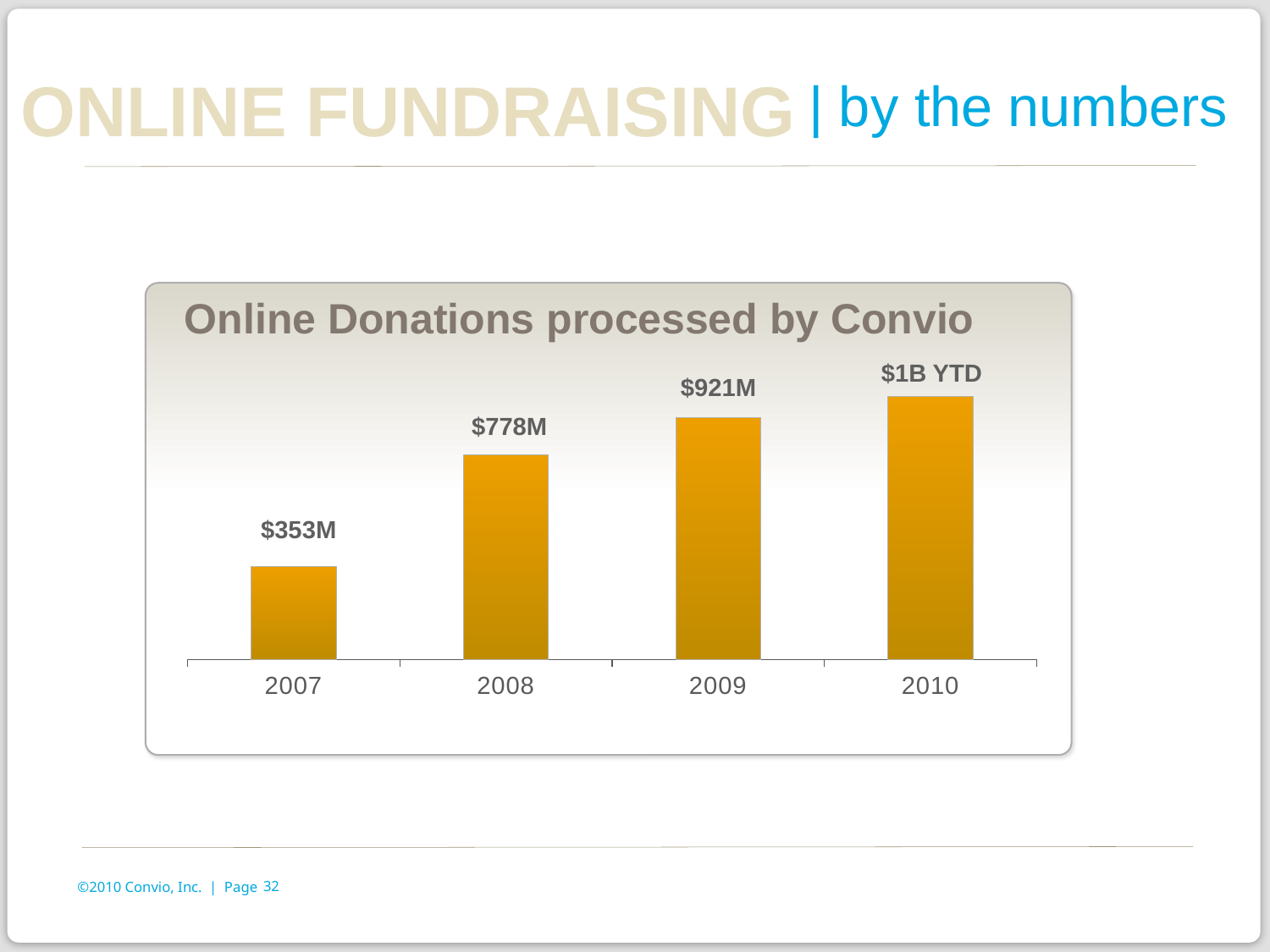
What label is shown above the 2010 bar in the Online Donations processed by Convio chart? $1B YTD Which is larger in the Online Donations processed by Convio chart, the value for 2008 or the value for 2009? 2009 What is the difference between the 2009 and 2008 values in the Online Donations processed by Convio chart? $143M What kind of chart is the Online Donations processed by Convio chart? Bar chart What value is shown for 2008 in the Online Donations processed by Convio chart? $778M Which year has the lowest value in the Online Donations processed by Convio chart? 2007 Which year has the highest bar in the Online Donations processed by Convio chart? 2010 What is the difference between the 2008 and 2007 values in the Online Donations processed by Convio chart? $425M Do the values in the Online Donations processed by Convio chart rise or fall from 2007 to 2010? Rise How many years are shown on the x axis of the Online Donations processed by Convio chart? 4 What value is shown for 2009 in the Online Donations processed by Convio chart? $921M What value is shown for 2007 in the Online Donations processed by Convio chart? $353M